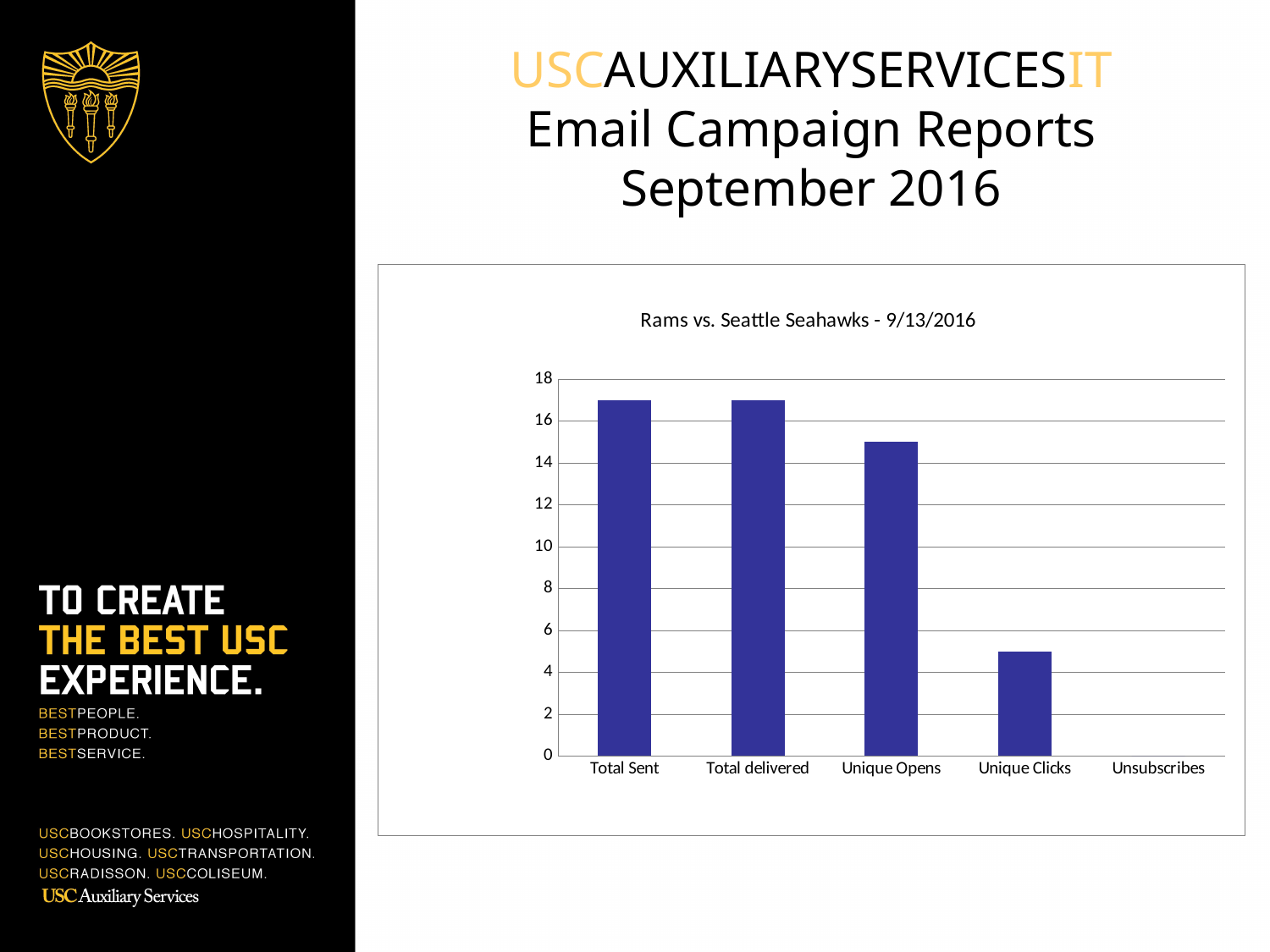
What kind of chart is shown on the slide? bar chart What is the value for Unsubscribes? 0 What is the title of the chart? Rams vs. Seattle Seahawks - 9/13/2016 How many categories are shown on the x axis of the chart? 5 What is the highest value shown on the y axis of the chart? 18 Which is larger, the value for Unique Opens or the value for Unique Clicks? Unique Opens Do the values generally rise or fall moving from left to right along the x axis? fall Is the value for Total Sent greater or less than 16? greater Is the value for Total delivered greater or less than 16? greater Which category has the lowest value in the chart? Unsubscribes Is the value for Unique Opens greater or less than 14? greater